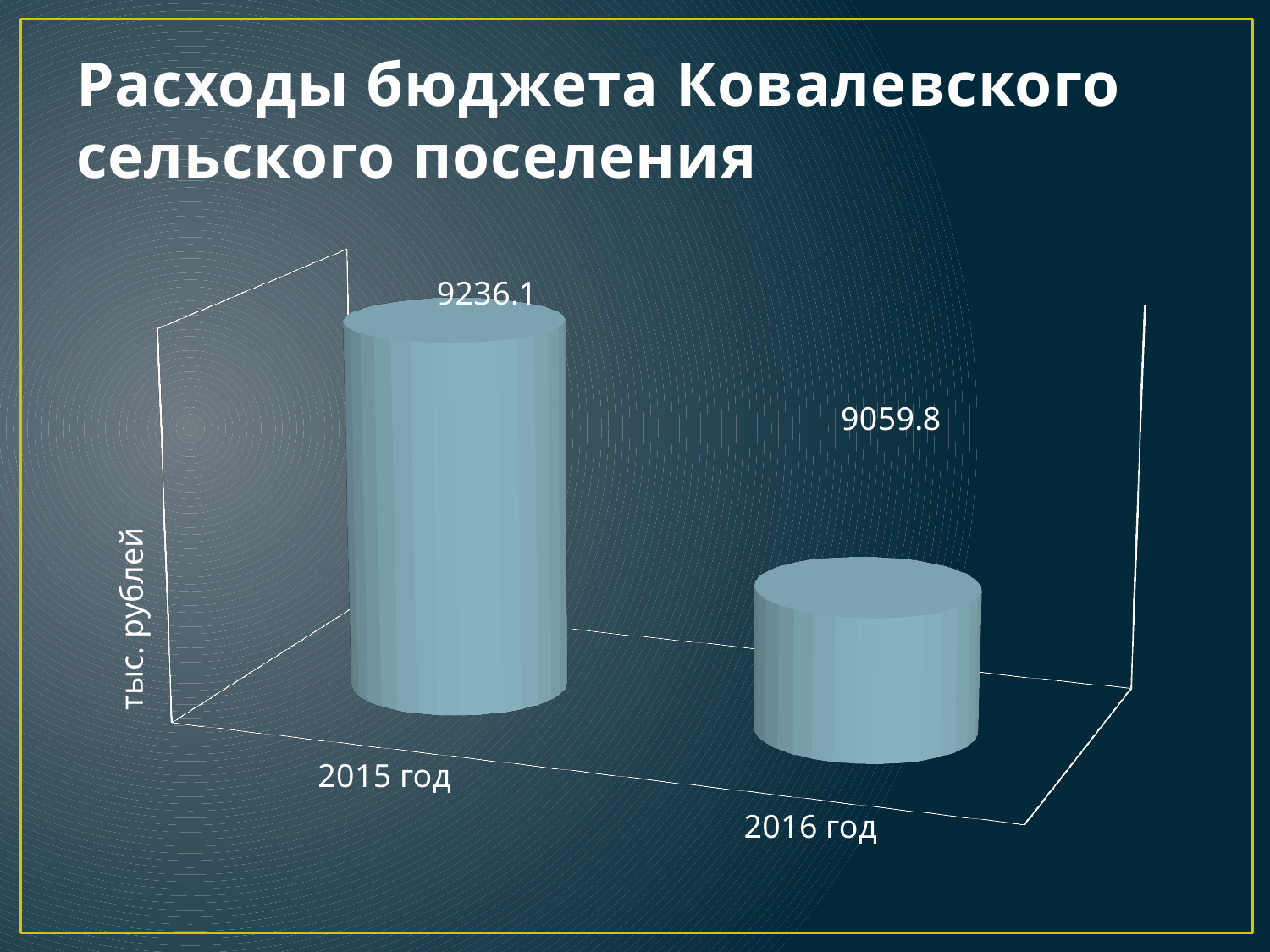
What is the label on the vertical axis? тыс. рублей Which is larger, the value for 2015 год or for 2016 год? 2015 год Which year has the highest value? 2015 год What is the title of the slide? Расходы бюджета Ковалевского сельского поселения Which year has the lowest value? 2016 год How many categories are shown on the chart? 2 What is the value for 2015 год? 9236.1 What is the difference between the values for 2015 год and 2016 год? 176.3 What kind of chart is shown on the slide? bar chart Do the values rise or fall from 2015 год to 2016 год? fall What is the value for 2016 год? 9059.8